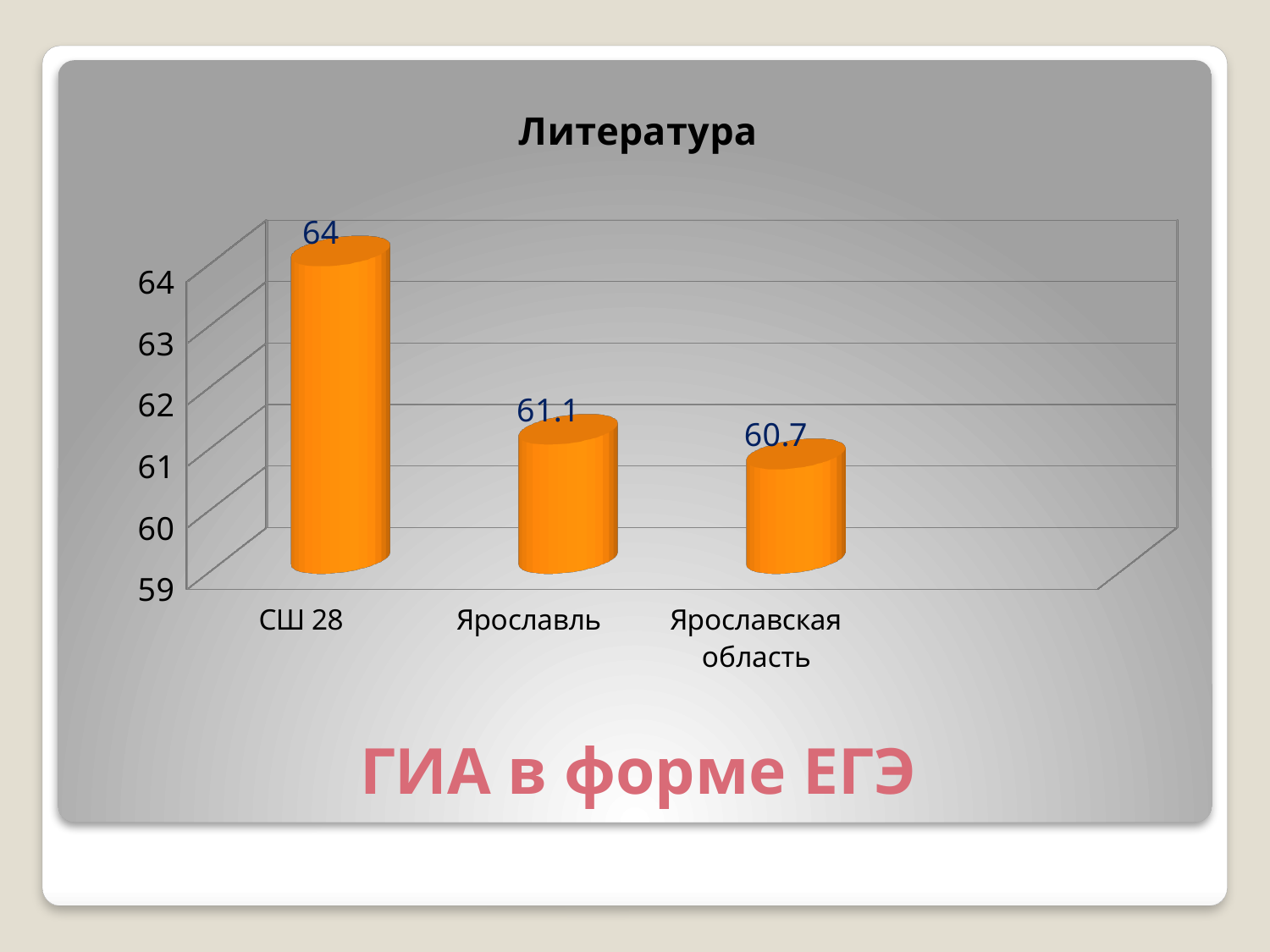
Which is larger, the value for СШ 28 or the value for Ярославская область? СШ 28 What is the difference between the values for СШ 28 and Ярославль? 2.9 What is the difference between the values for Ярославль and Ярославская область? 0.4 What is the title of the chart? Литература What is the value for Ярославская область? 60.7 How many categories are shown on the chart? 3 What is the value for Ярославль? 61.1 What kind of chart is shown on the slide? bar chart What is the value for СШ 28? 64 Is the value for Ярославль greater or less than 62? less Which category has the highest value? СШ 28 Which category has the lowest value? Ярославская область